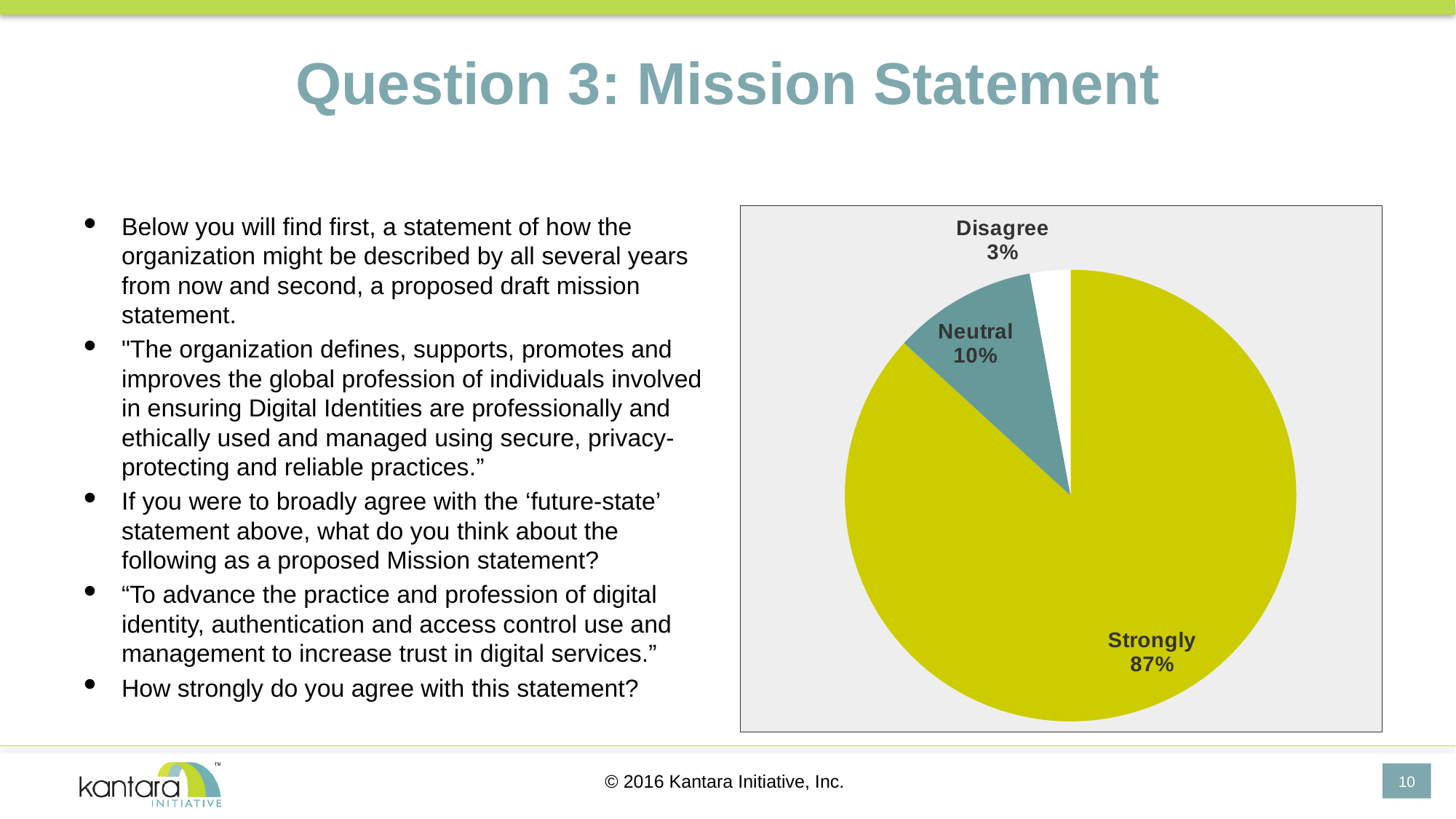
What kind of chart is shown on the slide? pie chart What is the difference in percentage points between the Neutral and Disagree slices? 7 How many slices does the pie chart have? 3 What colour is the Strongly slice of the pie? yellow-green What colour is the Neutral slice of the pie? teal What share of the pie does the Neutral slice represent? 10% Which slice of the pie is the smallest? Disagree Which is larger, the Neutral slice or the Disagree slice? Neutral What share of the pie does the Disagree slice represent? 3% Which slice of the pie is the largest? Strongly What share of the pie does the Strongly slice represent? 87% What is the difference in percentage points between the Strongly and Neutral slices? 77